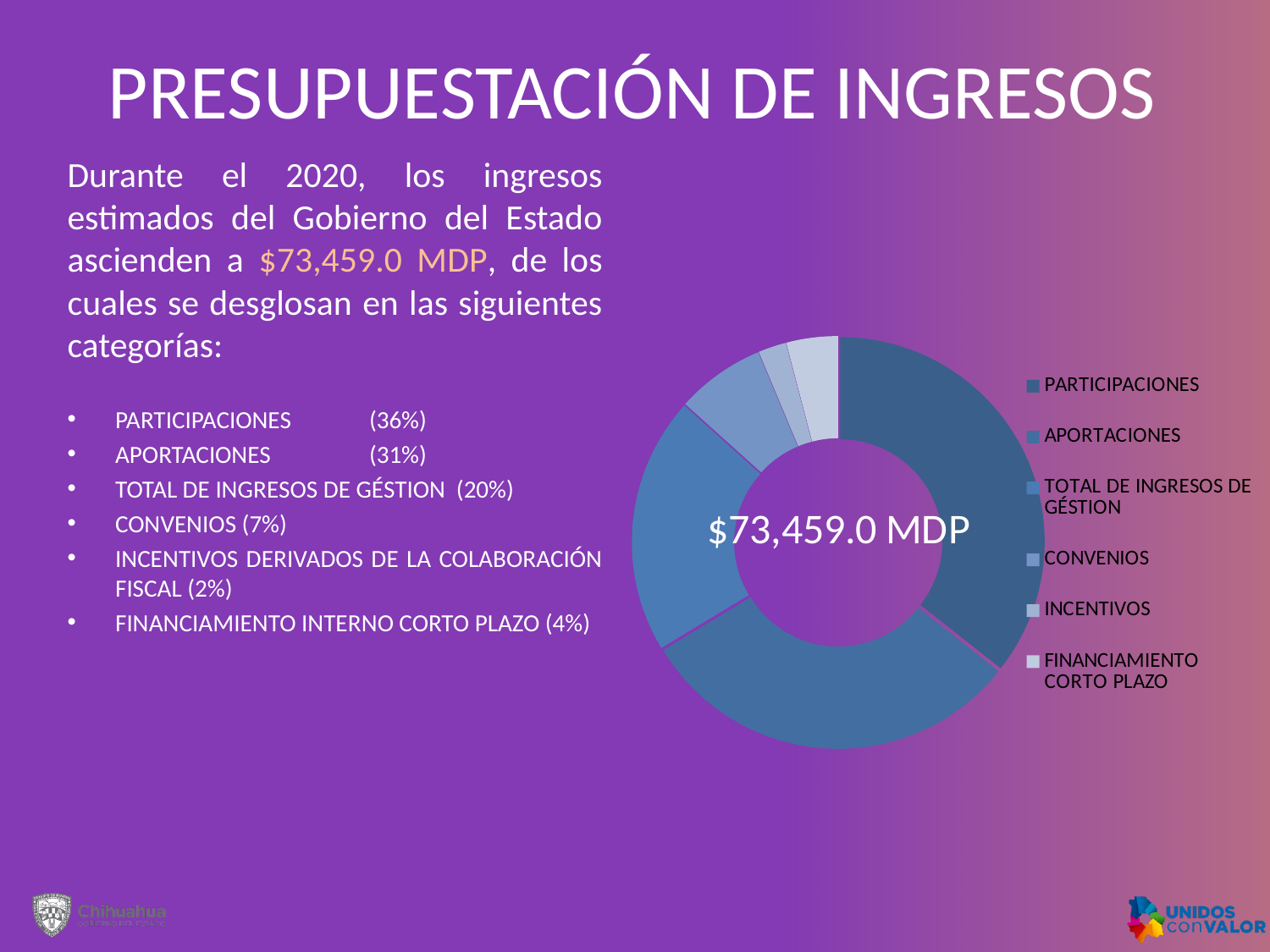
What share of the total do CONVENIOS represent, according to the slide? 7% What value is printed in the centre of the doughnut chart? $73,459.0 MDP What share of the total do PARTICIPACIONES represent, according to the slide? 36% Which slice is larger in the doughnut chart, CONVENIOS or TOTAL DE INGRESOS DE GÉSTION? TOTAL DE INGRESOS DE GÉSTION What is the last entry listed in the doughnut chart's legend? FINANCIAMIENTO CORTO PLAZO Which category has the smallest slice in the doughnut chart? INCENTIVOS Which slice is larger in the doughnut chart, PARTICIPACIONES or APORTACIONES? PARTICIPACIONES What share of the total does TOTAL DE INGRESOS DE GÉSTION represent, according to the slide? 20% Which category has the largest slice in the doughnut chart? PARTICIPACIONES What kind of chart is shown on the slide? Doughnut (pie) chart How many categories does the doughnut chart's legend list? 6